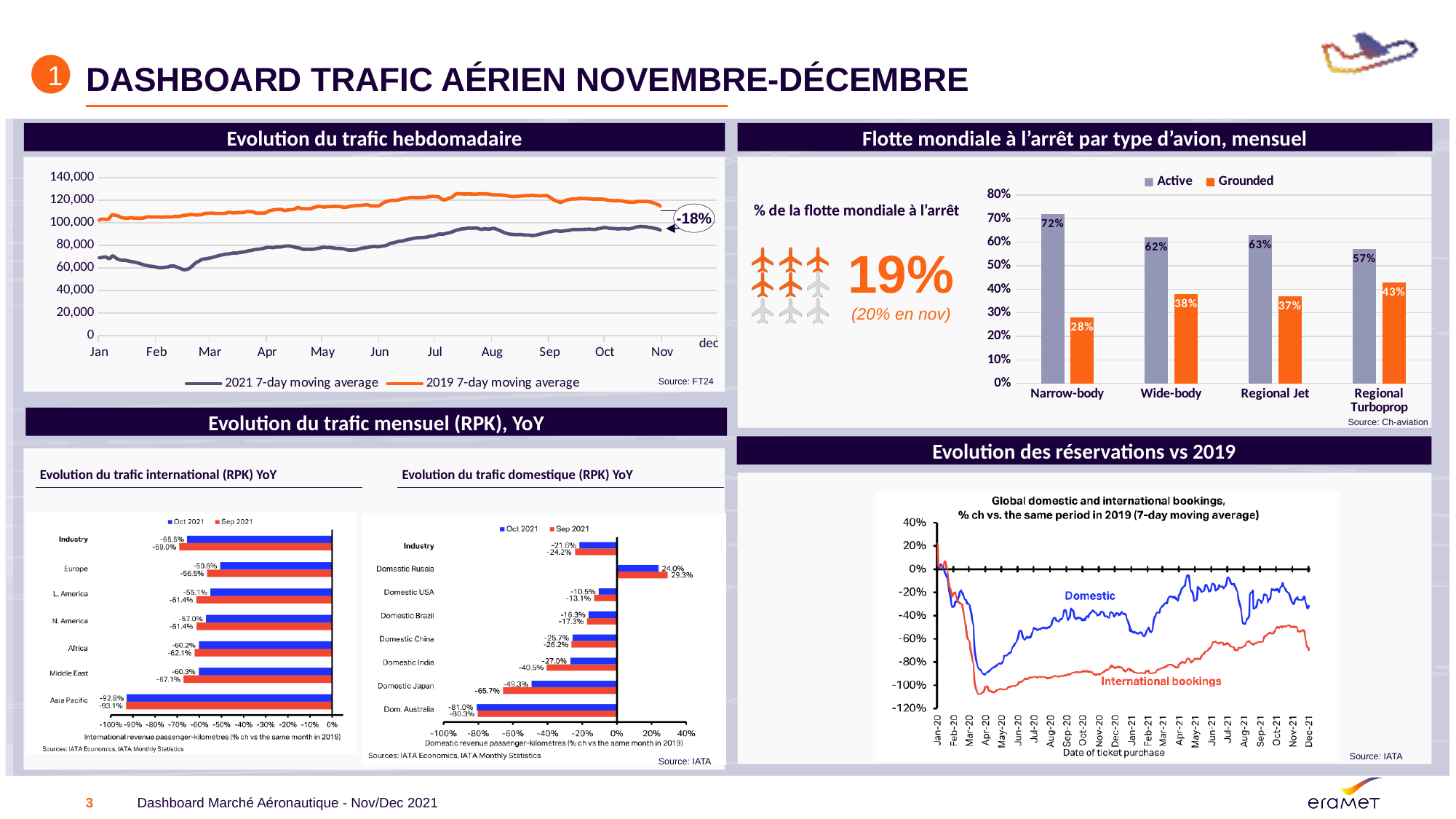
In the 'Evolution des réservations vs 2019' chart, which series is drawn in red? International bookings In the 'Evolution du trafic hebdomadaire' chart, is the 2021 7-day moving average in November greater or less than 80,000? greater In the 'Evolution du trafic international (RPK) YoY' chart, which region has the lowest Oct 2021 value? Asia Pacific What kind of chart is 'Evolution du trafic hebdomadaire'? Line chart In the 'Evolution du trafic hebdomadaire' chart, how many series does the legend list? 2 In the 'Flotte mondiale à l'arrêt par type d'avion, mensuel' chart, what is the difference between the Active values for Narrow-body and Wide-body? 10% In the 'Flotte mondiale à l'arrêt par type d'avion, mensuel' chart, how many aircraft types are shown on the x axis? 4 In the 'Evolution du trafic domestique (RPK) YoY' chart, which is larger: the Oct 2021 value for Domestic USA or for Domestic Japan? Domestic USA In the 'Flotte mondiale à l'arrêt par type d'avion, mensuel' chart, which aircraft type has the highest Grounded share? Regional Turboprop In the 'Evolution du trafic international (RPK) YoY' chart, what is the Oct 2021 value for Asia Pacific? -92.8% In the 'Evolution du trafic domestique (RPK) YoY' chart, what is the Sep 2021 value for Domestic Russia? 29.3% In the 'Flotte mondiale à l'arrêt par type d'avion, mensuel' chart, what is the Grounded value for Narrow-body? 28%